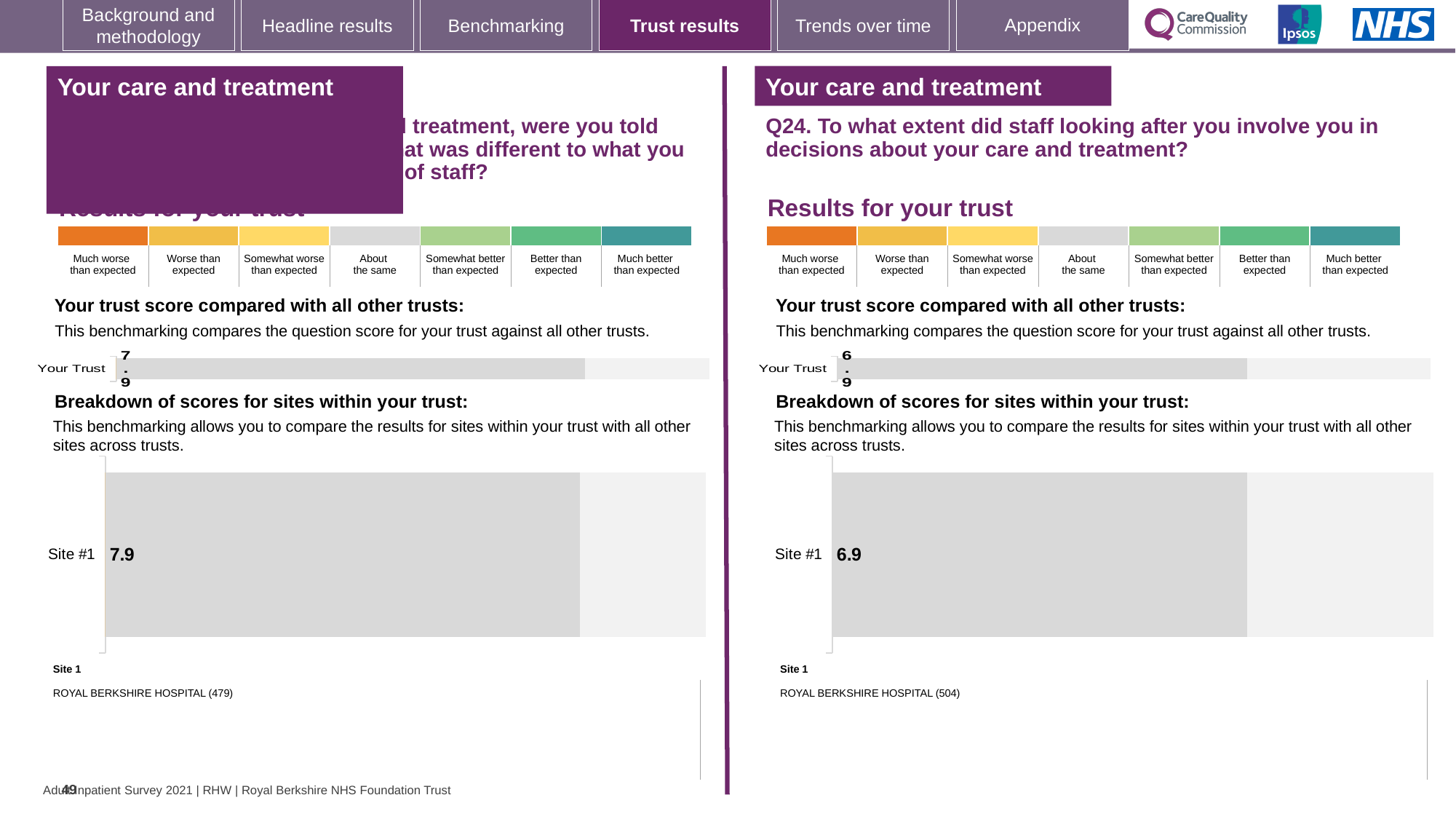
What kind of chart is used for the breakdown of scores for sites on the right panel (Q24)? Bar chart On the right panel (Q24), is the Site #1 score greater or less than the Your Trust score on the left panel? less How many sites are shown in the breakdown of scores chart on the right panel (Q24)? 1 On the right panel (Q24), what is the value shown for Your Trust in the trust score comparison chart? 6.9 Which Site #1 score is larger: the one on the left panel or the one on the right panel (Q24)? Left panel On the right panel (Q24), which site name is listed for Site 1 below the chart? ROYAL BERKSHIRE HOSPITAL (504) On the left panel, what is the score shown for Site #1 in the breakdown of scores for sites within your trust? 7.9 On the left panel, which site name is listed for Site 1 below the chart? ROYAL BERKSHIRE HOSPITAL (479) On the right panel (Q24), what is the score shown for Site #1 in the breakdown of scores for sites within your trust? 6.9 On the left panel, what is the value shown for Your Trust in the trust score comparison chart? 7.9 What is the difference between the Site #1 score on the left panel and the Site #1 score on the right panel (Q24)? 1.0 How many sites are shown in the breakdown of scores chart on the left panel? 1